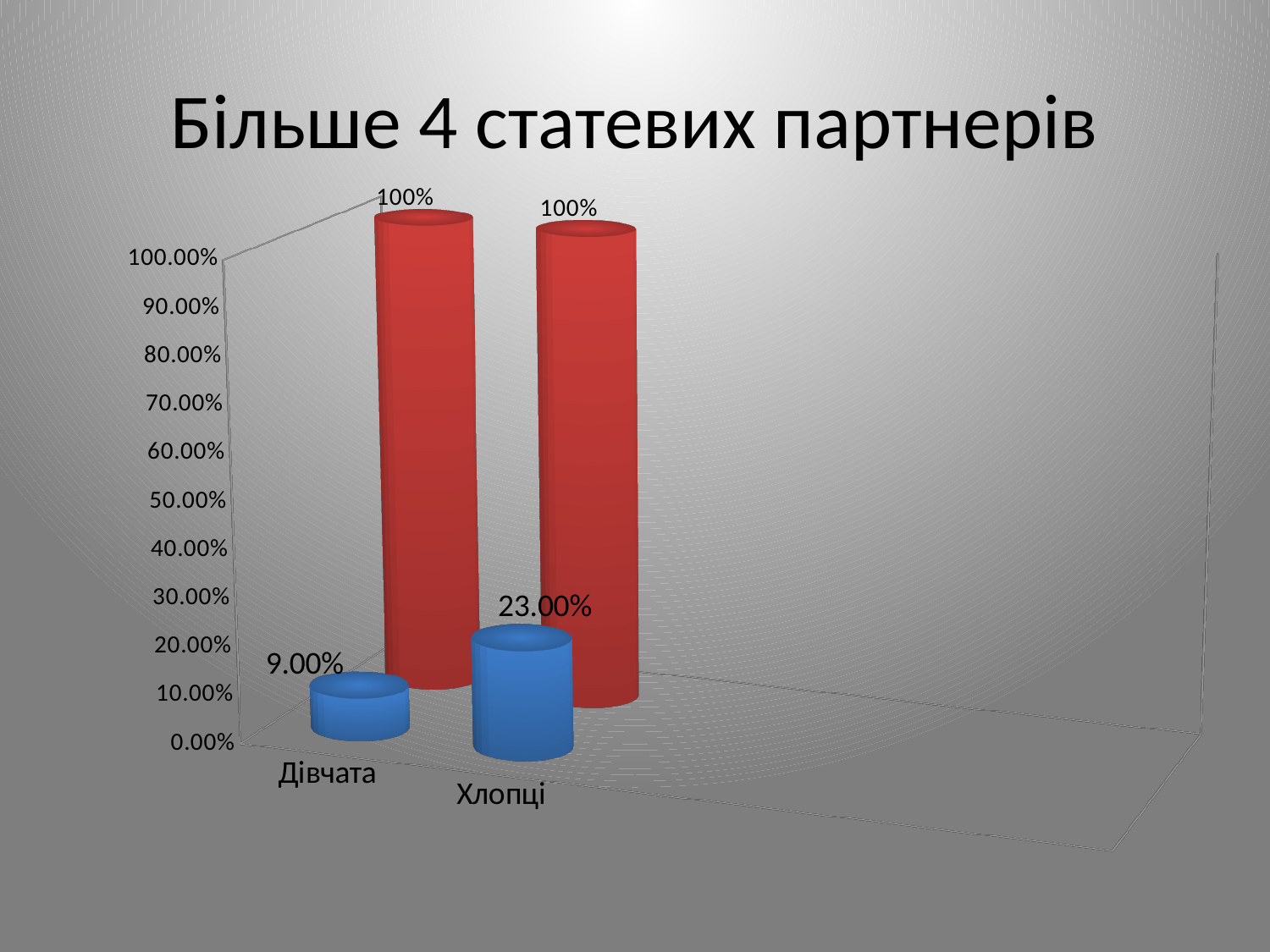
What is the difference between the blue bar values for Хлопці and Дівчата? 14.00% What is the value of the blue bar for Хлопці? 23.00% Which category has the lowest blue bar value? Дівчата Is the blue bar value for Хлопці greater or less than 20.00%? greater Which category has the higher blue bar, Дівчата or Хлопці? Хлопці What is the title of the chart? Більше 4 статевих партнерів What kind of chart is shown on the slide? Bar chart What is the value of the blue bar for Дівчата? 9.00% What is the value of the red bar for Дівчата? 100% Is the blue bar value for Дівчата greater or less than 10.00%? less How many categories are shown on the x axis? 2 What is the value of the red bar for Хлопці? 100%